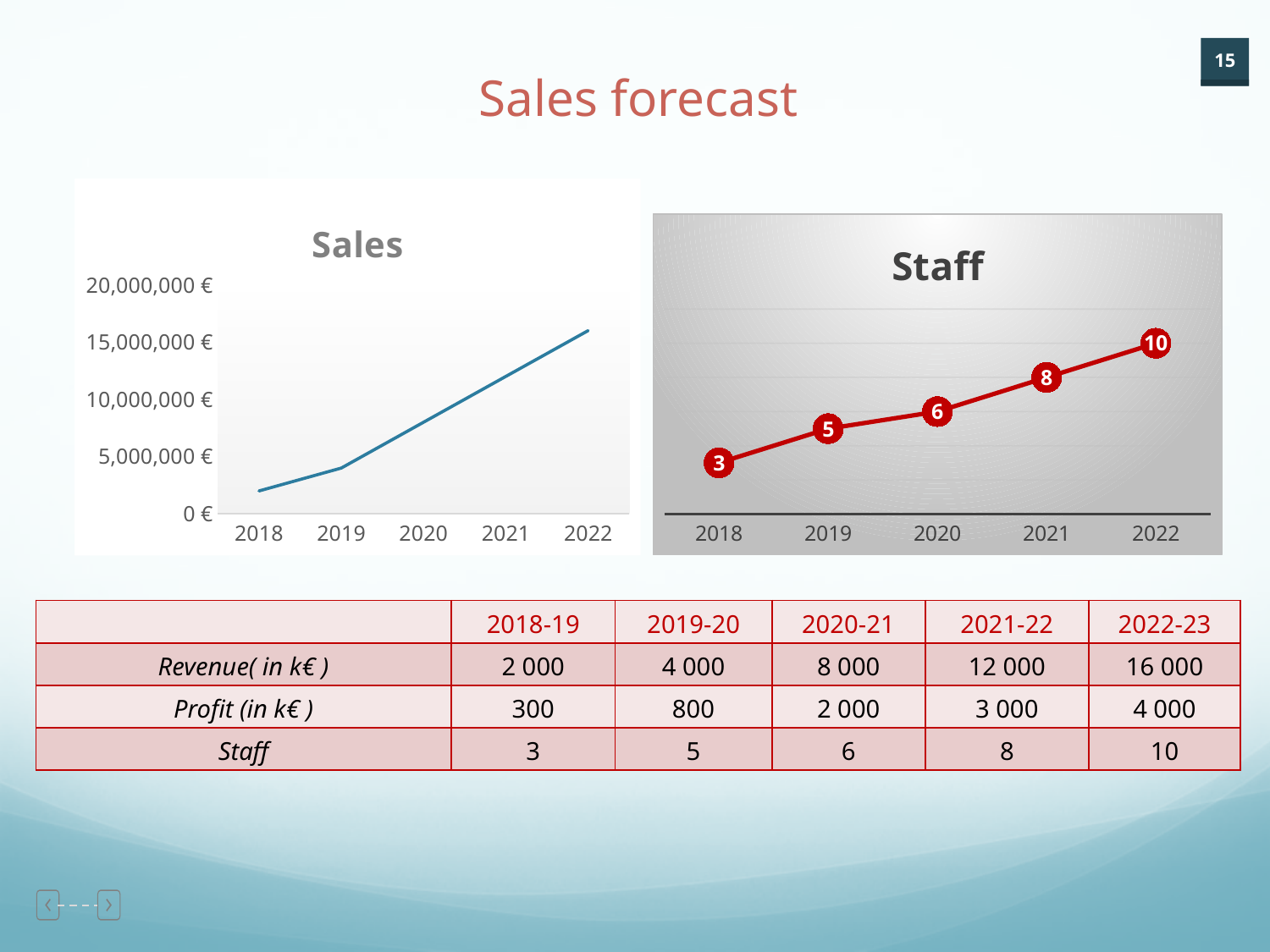
In the Staff chart, what is the value for 2022? 10 In the Staff chart, what is the value for 2020? 6 In the Staff chart, do the values rise or fall from 2018 to 2022? rise In the Sales chart, which year has the higher value, 2020 or 2021? 2021 In the Staff chart, what is the value for 2018? 3 In the Sales chart, is the value for 2022 greater or less than 15,000,000 €? greater In the Staff chart, which year has the lowest value? 2018 In the Staff chart, what is the difference between the values for 2021 and 2019? 3 In the Staff chart, how many data points are plotted? 5 In the Staff chart, which year has the highest value? 2022 What kind of chart is the Sales chart? line chart In the Sales chart, is the value for 2019 greater or less than 5,000,000 €? less